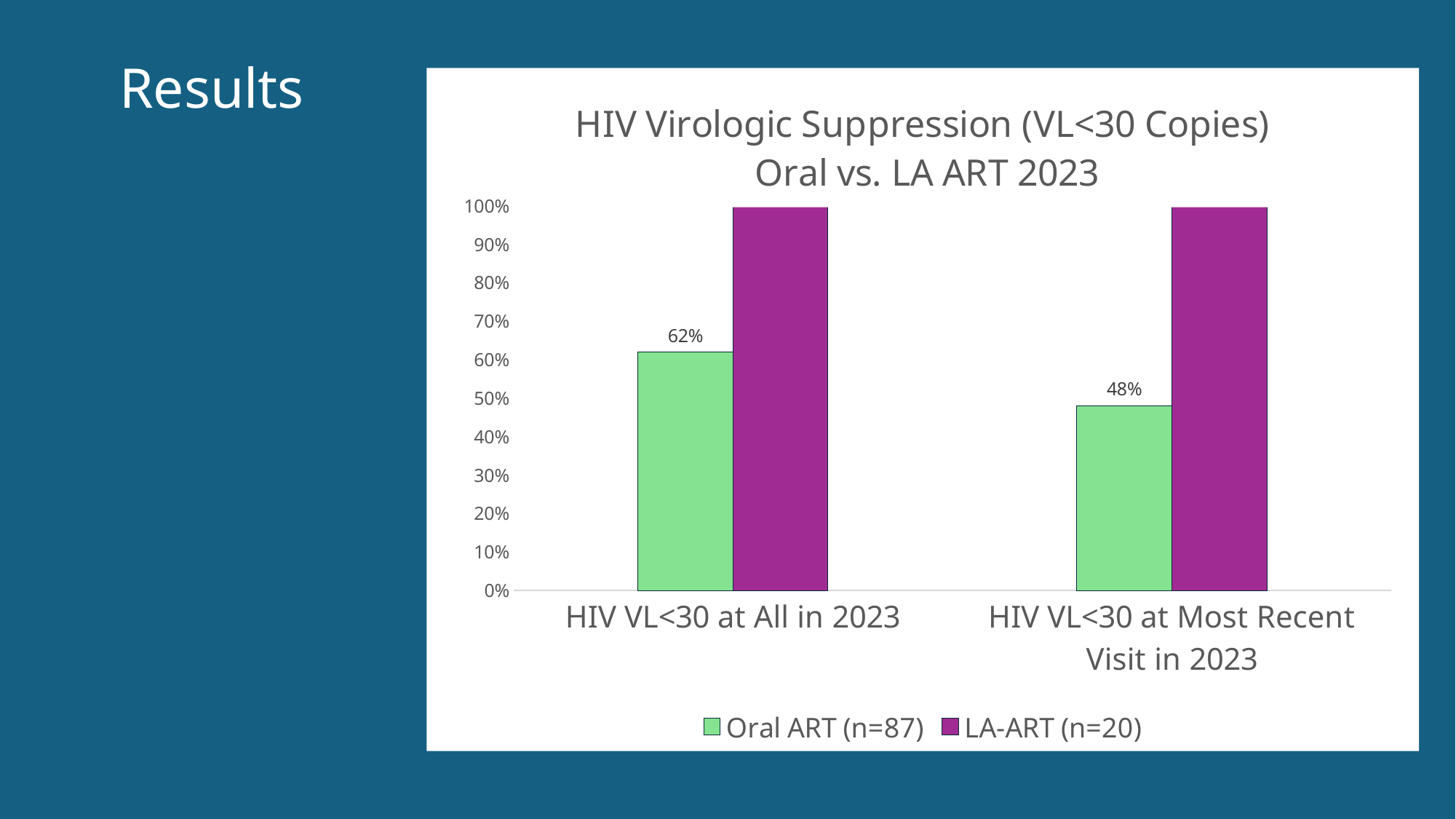
What is the value for Oral ART (n=87) in the 'HIV VL<30 at All in 2023' category? 62% What kind of chart is shown on the slide? Bar chart Is the LA-ART (n=20) value for 'HIV VL<30 at Most Recent Visit in 2023' greater or less than 90%? greater In the 'HIV VL<30 at All in 2023' category, which series has the larger value, Oral ART (n=87) or LA-ART (n=20)? LA-ART (n=20) What is the difference between the Oral ART values for 'HIV VL<30 at All in 2023' and 'HIV VL<30 at Most Recent Visit in 2023'? 14% How many series does the legend list? 2 What is the value for Oral ART (n=87) in the 'HIV VL<30 at Most Recent Visit in 2023' category? 48% What is the value for LA-ART (n=20) in the 'HIV VL<30 at All in 2023' category? 100% Is the Oral ART (n=87) value for 'HIV VL<30 at Most Recent Visit in 2023' greater or less than 50%? less How many categories are shown on the x axis? 2 Which colour represents the LA-ART (n=20) series? Purple Which category has the lower Oral ART (n=87) value? HIV VL<30 at Most Recent Visit in 2023